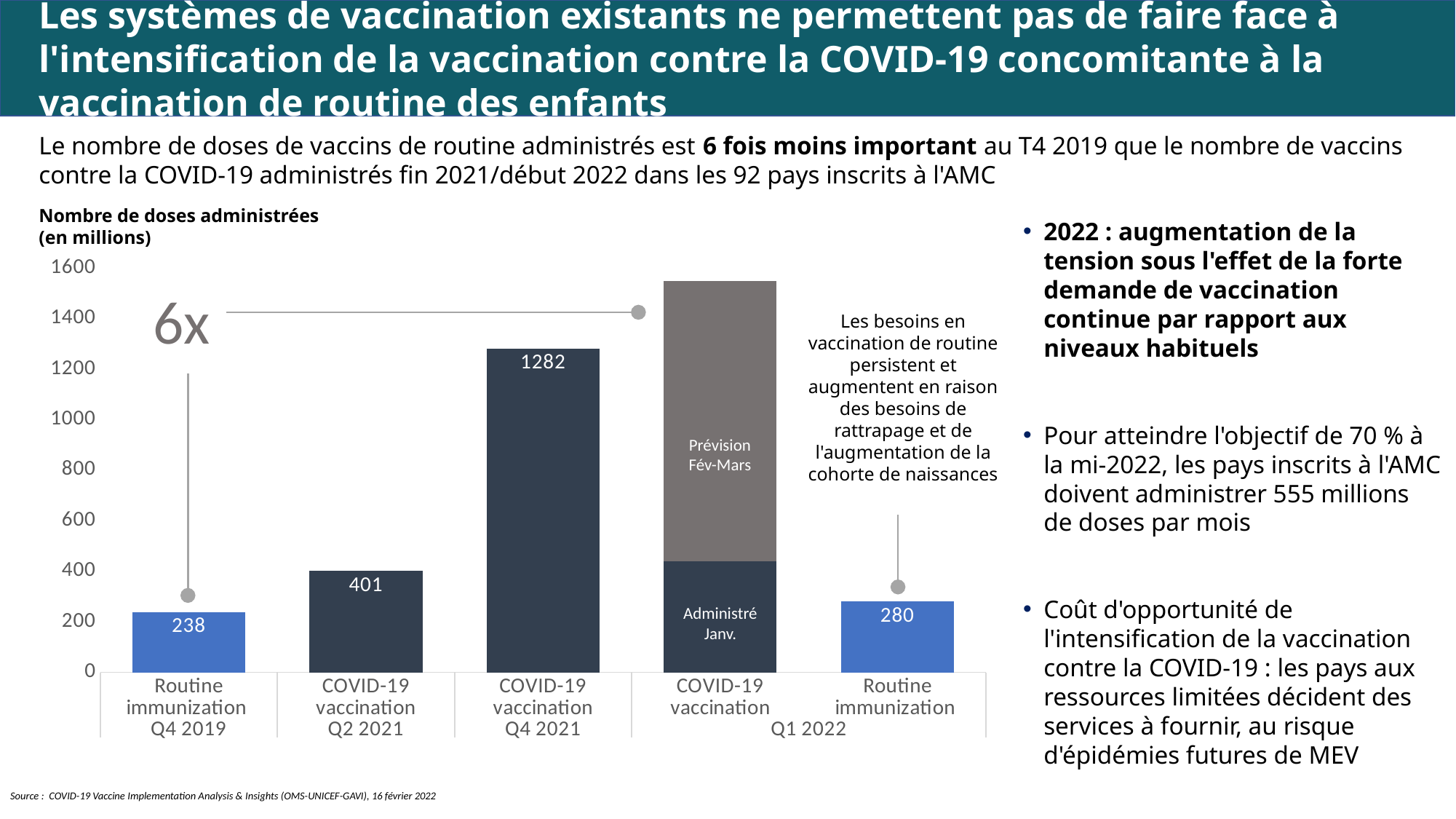
Which bar has the lowest value? Routine immunization Q4 2019 What is the difference between COVID-19 vaccination Q4 2021 and COVID-19 vaccination Q2 2021? 881 What kind of chart is shown on the slide? bar chart What is the value for Routine immunization Q4 2019? 238 What is the value for Routine immunization Q1 2022? 280 What is the axis title of the chart? Nombre de doses administrées (en millions) What is the difference between Routine immunization Q1 2022 and Routine immunization Q4 2019? 42 Is the total value of the stacked COVID-19 vaccination Q1 2022 bar greater or less than 1400? greater What is the value for COVID-19 vaccination Q2 2021? 401 What is the value for COVID-19 vaccination Q4 2021? 1282 How many bars are shown in the chart? 5 Which is larger: Routine immunization Q4 2019 or Routine immunization Q1 2022? Routine immunization Q1 2022